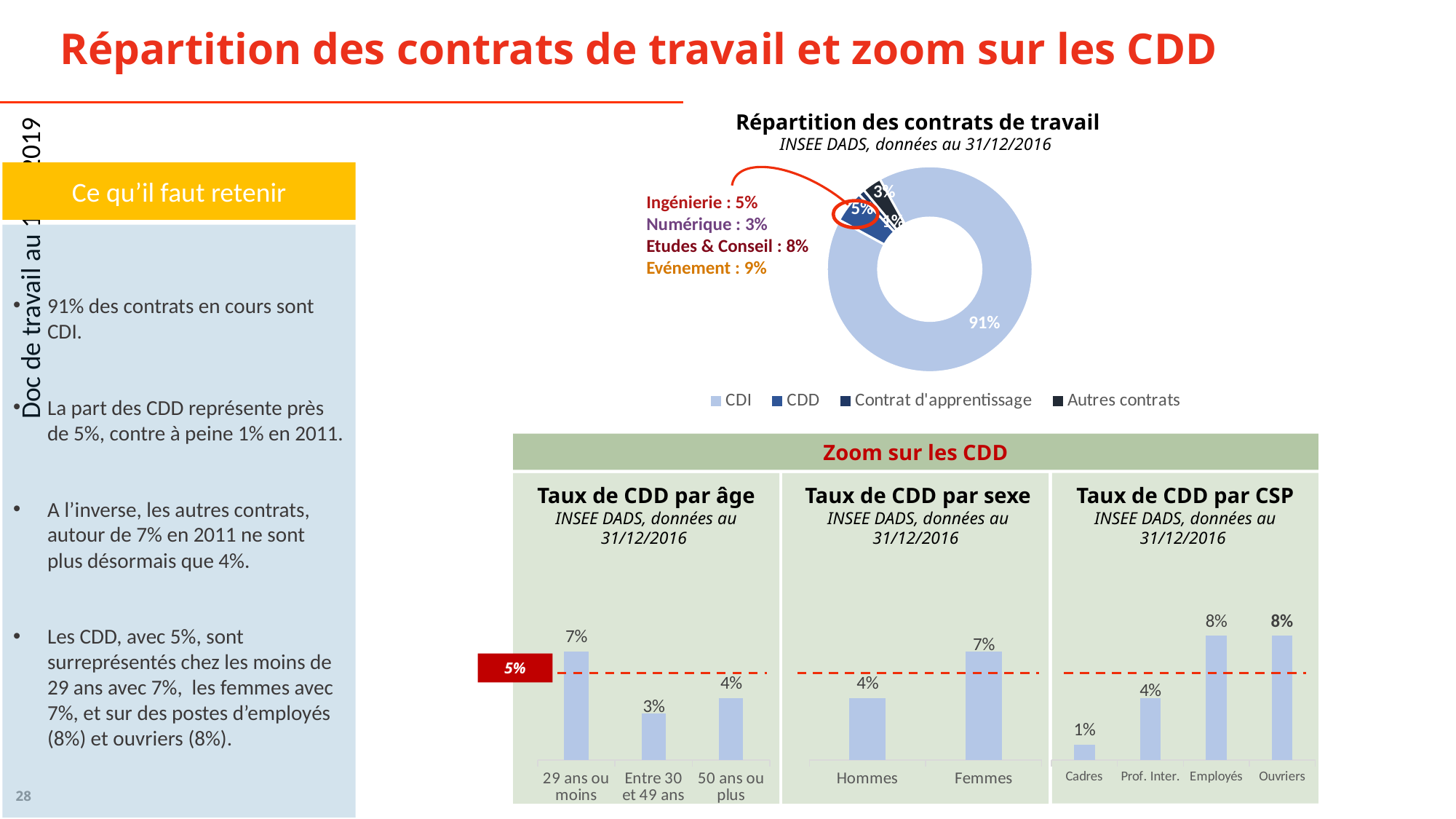
In the 'Répartition des contrats de travail' chart, what share of contracts are CDD? 5% In the 'Taux de CDD par CSP' chart, what is the difference between Employés and Prof. Inter.? 4% In the 'Taux de CDD par sexe' chart, which is larger, Hommes or Femmes? Femmes How many entries does the legend of the 'Répartition des contrats de travail' chart list? 4 In the 'Répartition des contrats de travail' chart, what share of contracts are CDI? 91% In the 'Taux de CDD par âge' chart, what is the value for '29 ans ou moins'? 7% In the 'Taux de CDD par âge' chart, what is the difference between '29 ans ou moins' and '50 ans ou plus'? 3% In the 'Taux de CDD par sexe' chart, what is the value for Femmes? 7% In the 'Taux de CDD par âge' chart, which age group has the lowest CDD rate? Entre 30 et 49 ans How many categories are shown in the 'Taux de CDD par CSP' chart? 4 In the 'Taux de CDD par CSP' chart, what is the value for Cadres? 1% What kind of chart is 'Répartition des contrats de travail'? Donut (pie) chart